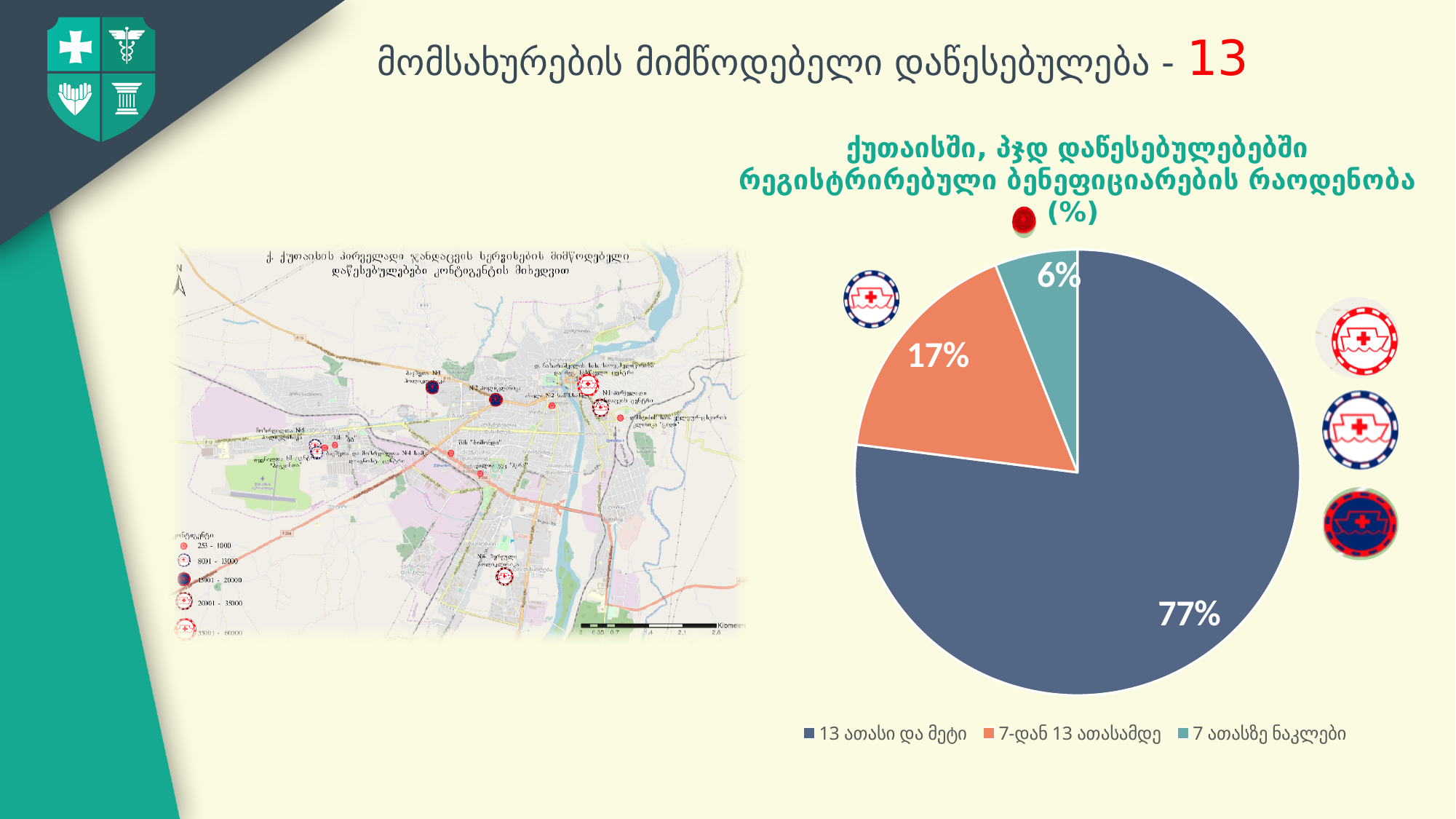
In the pie chart, what share is shown for the category "7-დან 13 ათასამდე"? 17% How many slices does the pie chart have? 3 In the pie chart, what share is shown for the category "7 ათასზე ნაკლები"? 6% Which slice is larger in the pie chart: "7-დან 13 ათასამდე" or "7 ათასზე ნაკლები"? 7-დან 13 ათასამდე In the pie chart, what share is shown for the category "13 ათასი და მეტი"? 77% How many entries does the pie chart legend list? 3 Which category has the smallest slice in the pie chart? 7 ათასზე ნაკლები What type of chart is shown on the right side of the slide? pie chart What colour is the slice for "7-დან 13 ათასამდე" in the pie chart? orange What is the combined share of the "7-დან 13 ათასამდე" and "7 ათასზე ნაკლები" slices? 23% Which category has the largest slice in the pie chart? 13 ათასი და მეტი What is the difference in percentage points between the "13 ათასი და მეტი" slice and the "7-დან 13 ათასამდე" slice? 60